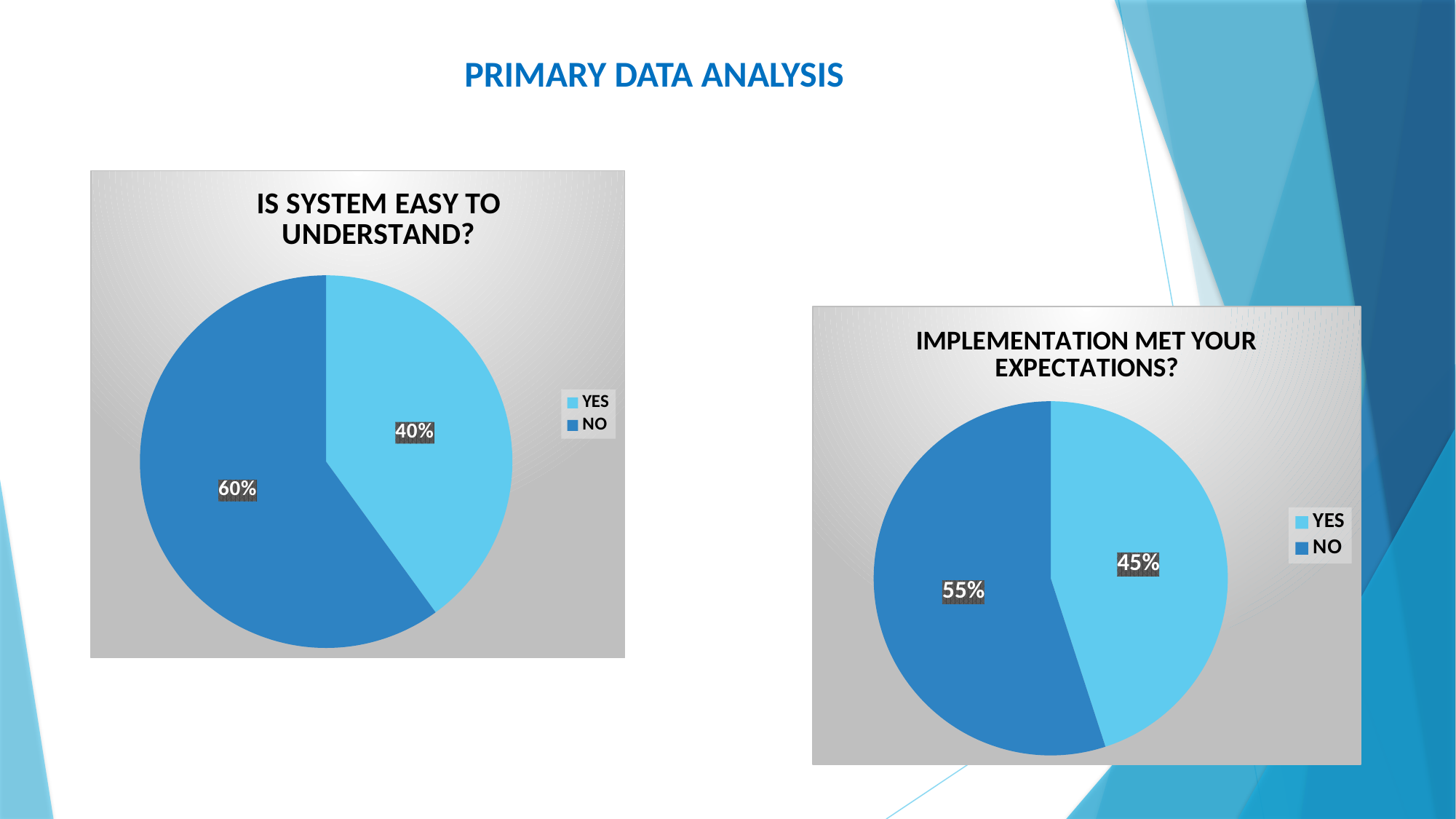
In the 'IS SYSTEM EASY TO UNDERSTAND?' chart, what is the difference between the NO and YES shares? 20% In the 'IMPLEMENTATION MET YOUR EXPECTATIONS?' chart, which response has the smallest share? YES In the 'IS SYSTEM EASY TO UNDERSTAND?' chart, what percentage answered YES? 40% In the 'IS SYSTEM EASY TO UNDERSTAND?' chart, which response has the largest share? NO In the 'IMPLEMENTATION MET YOUR EXPECTATIONS?' chart, which is larger, YES or NO? NO In the 'IMPLEMENTATION MET YOUR EXPECTATIONS?' chart, what percentage answered YES? 45% In the 'IMPLEMENTATION MET YOUR EXPECTATIONS?' chart, what percentage answered NO? 55% How many entries does the legend of the 'IMPLEMENTATION MET YOUR EXPECTATIONS?' chart list? 2 In the 'IS SYSTEM EASY TO UNDERSTAND?' chart, what percentage answered NO? 60% How many slices does the 'IS SYSTEM EASY TO UNDERSTAND?' pie chart have? 2 What type of chart is the 'IS SYSTEM EASY TO UNDERSTAND?' chart? Pie chart In the 'IMPLEMENTATION MET YOUR EXPECTATIONS?' chart, what is the difference between the NO and YES shares? 10%